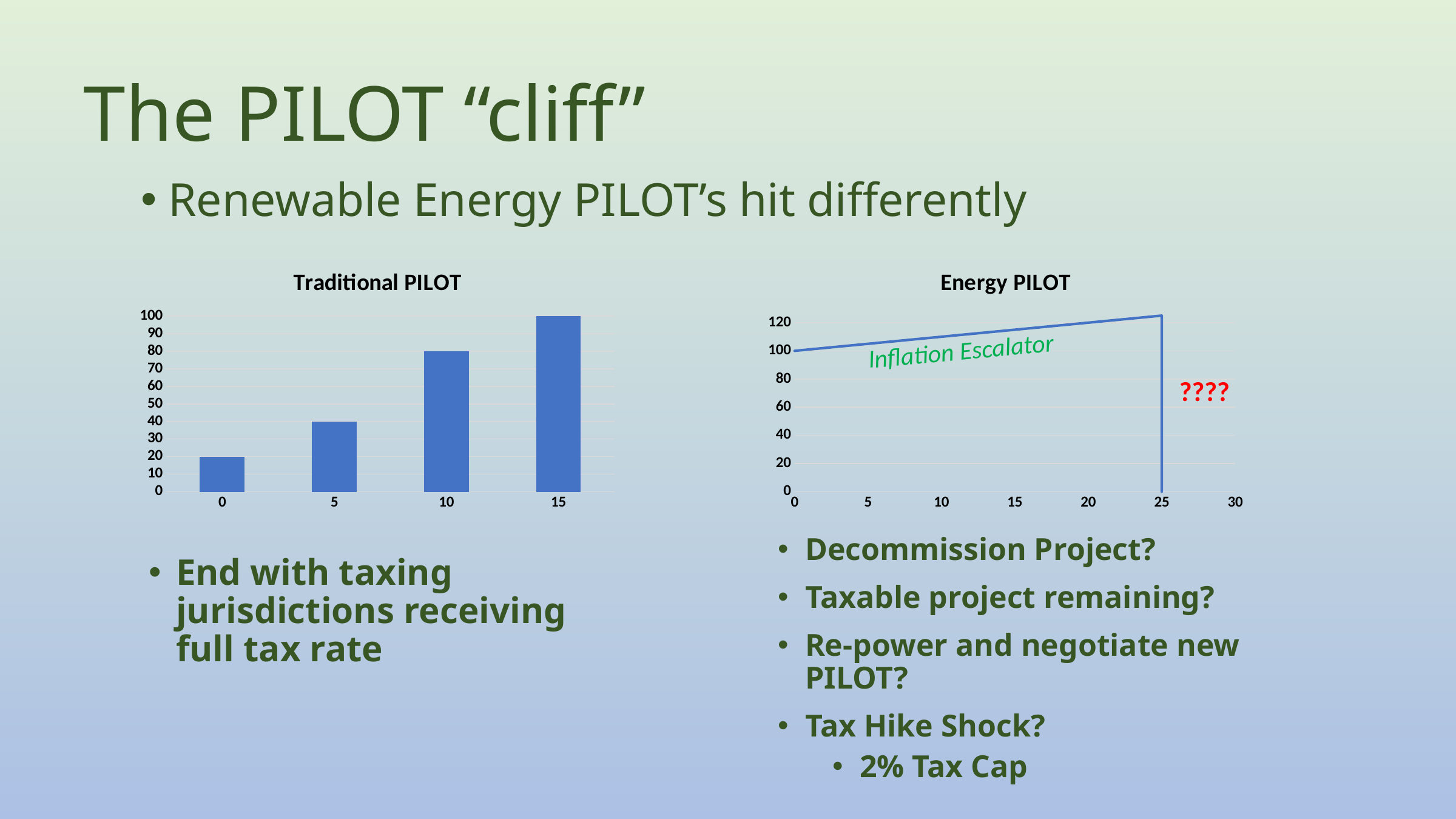
In the Traditional PILOT chart, which category has the highest value? 15 In the Traditional PILOT chart, how many bars are plotted? 4 In the Energy PILOT chart, what label is written in green along the rising line? Inflation Escalator In the Energy PILOT chart, what is the value at x = 0? 100 In the Traditional PILOT chart, what is the difference between the values for category 15 and category 5? 60 In the Energy PILOT chart, is the value just before the drop at x = 25 greater or less than 120? greater In the Traditional PILOT chart, which is larger, the value for category 5 or the value for category 10? 10 In the Traditional PILOT chart, which category has the lowest value? 0 In the Traditional PILOT chart, what is the value for category 0? 20 What kind of chart is the Traditional PILOT chart? bar chart In the Traditional PILOT chart, what is the value for category 10? 80 In the Traditional PILOT chart, do the values rise or fall from left to right along the x axis? rise